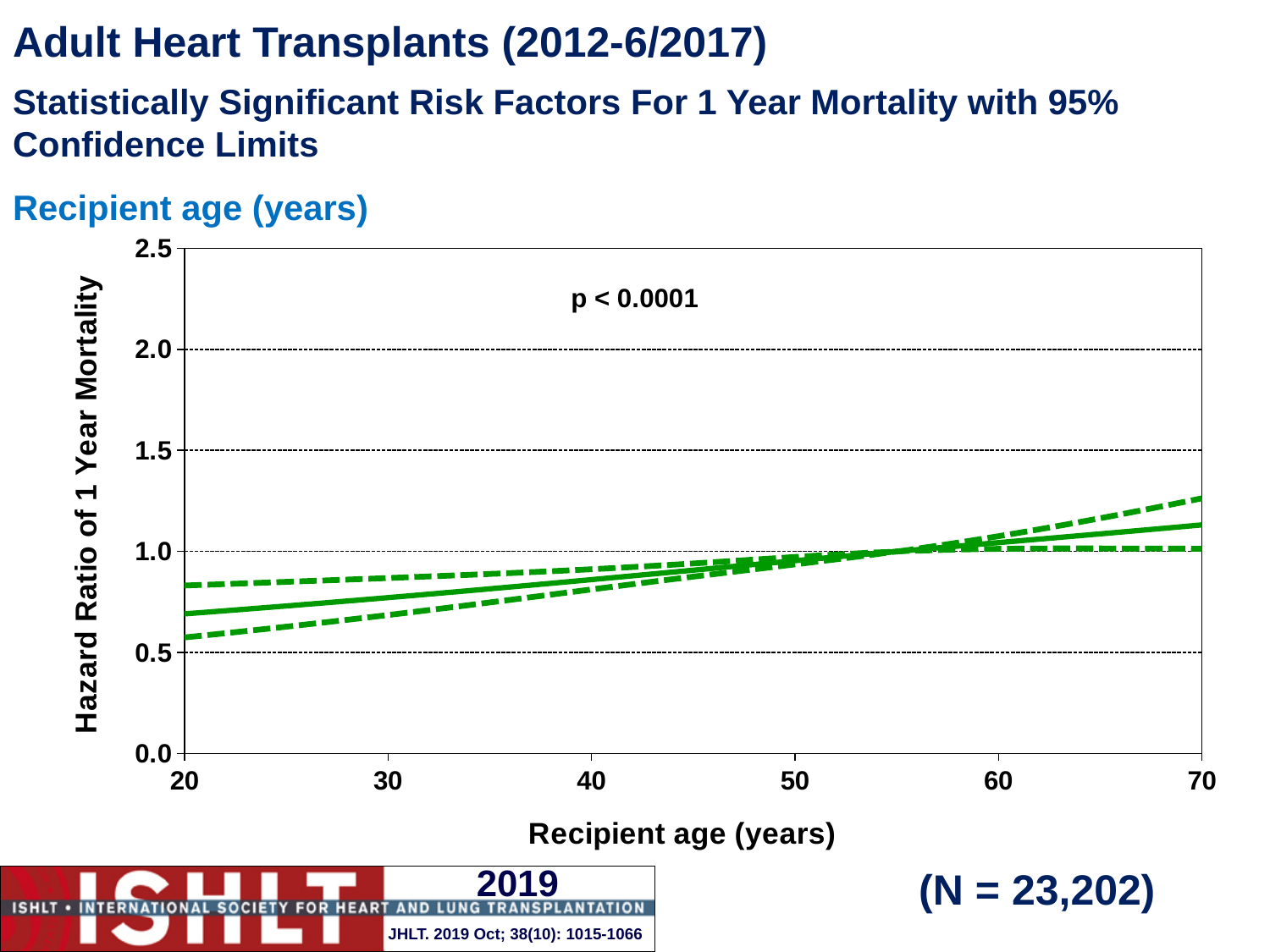
Does the hazard ratio of 1 year mortality rise or fall as recipient age increases from 20 to 70 years? rise Is the upper dashed confidence limit at recipient age 70 greater or less than 1.0? greater How many lines are plotted on the chart? 3 Is the hazard ratio on the solid line at recipient age 20 greater or less than 0.5? greater What is the sample size (N) shown on the slide? N = 23,202 Is the upper dashed confidence limit at recipient age 20 greater or less than 1.0? less What kind of chart is shown on the slide? line chart What p-value is printed on the chart? p < 0.0001